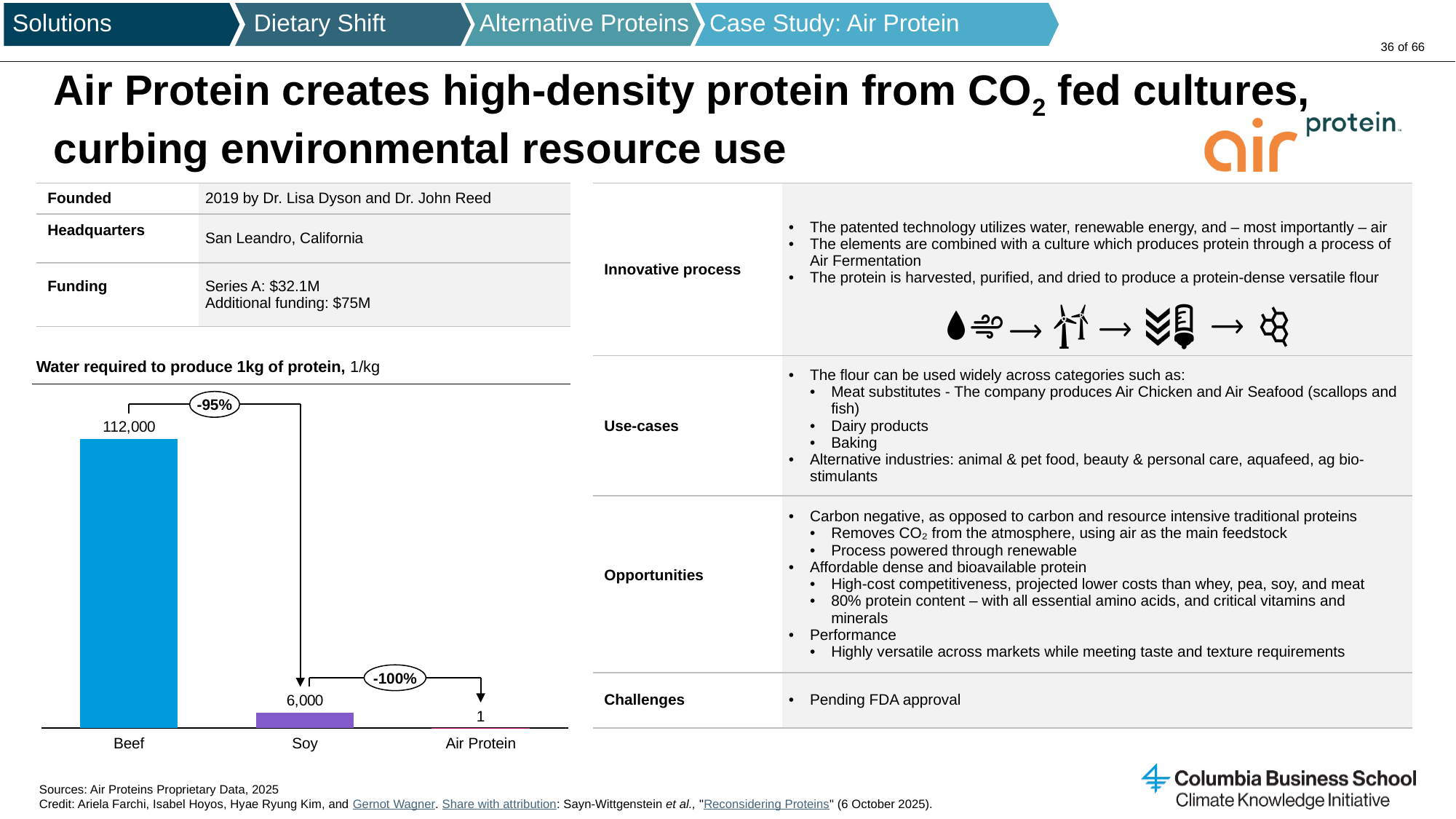
What is the water required to produce 1kg of protein for Soy? 6,000 How many categories are shown in the water required chart? 3 Which requires more water to produce 1kg of protein, Soy or Air Protein? Soy What is the difference in water required between Soy and Air Protein? 5,999 Which category requires the least water to produce 1kg of protein? Air Protein What is the difference in water required between Beef and Soy? 106,000 What is the water required to produce 1kg of protein for Beef? 112,000 Which category requires the most water to produce 1kg of protein? Beef What kind of chart is used to show water required to produce 1kg of protein? Bar chart What percentage change is labelled between Beef and Soy in the chart? -95% What is the water required to produce 1kg of protein for Air Protein? 1 Do the values rise or fall from Beef to Air Protein along the x axis? Fall